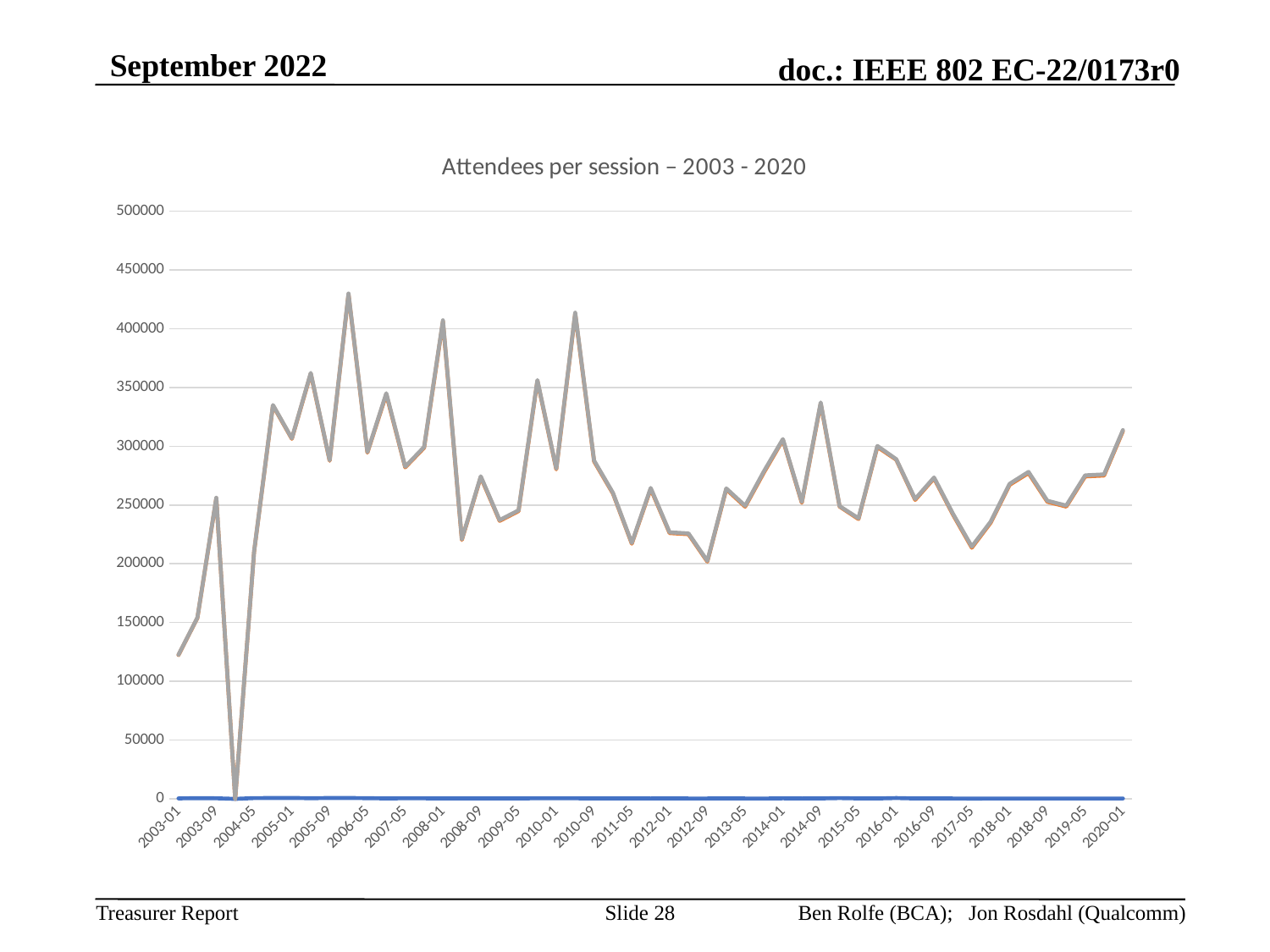
Is the value for 2017-05 greater or less than 250000? less Which is larger, the value for 2010-09 or the value for 2011-05? 2010-09 Is the value for 2004-05 greater or less than 50000? greater What kind of chart is shown on the slide? line chart Do the values rise or fall from 2003-01 to 2003-09? rise Is the value for 2012-09 greater or less than 250000? less Which is larger, the value for 2003-01 or the value for 2020-01? 2020-01 What is the title of the chart? Attendees per session – 2003 - 2020